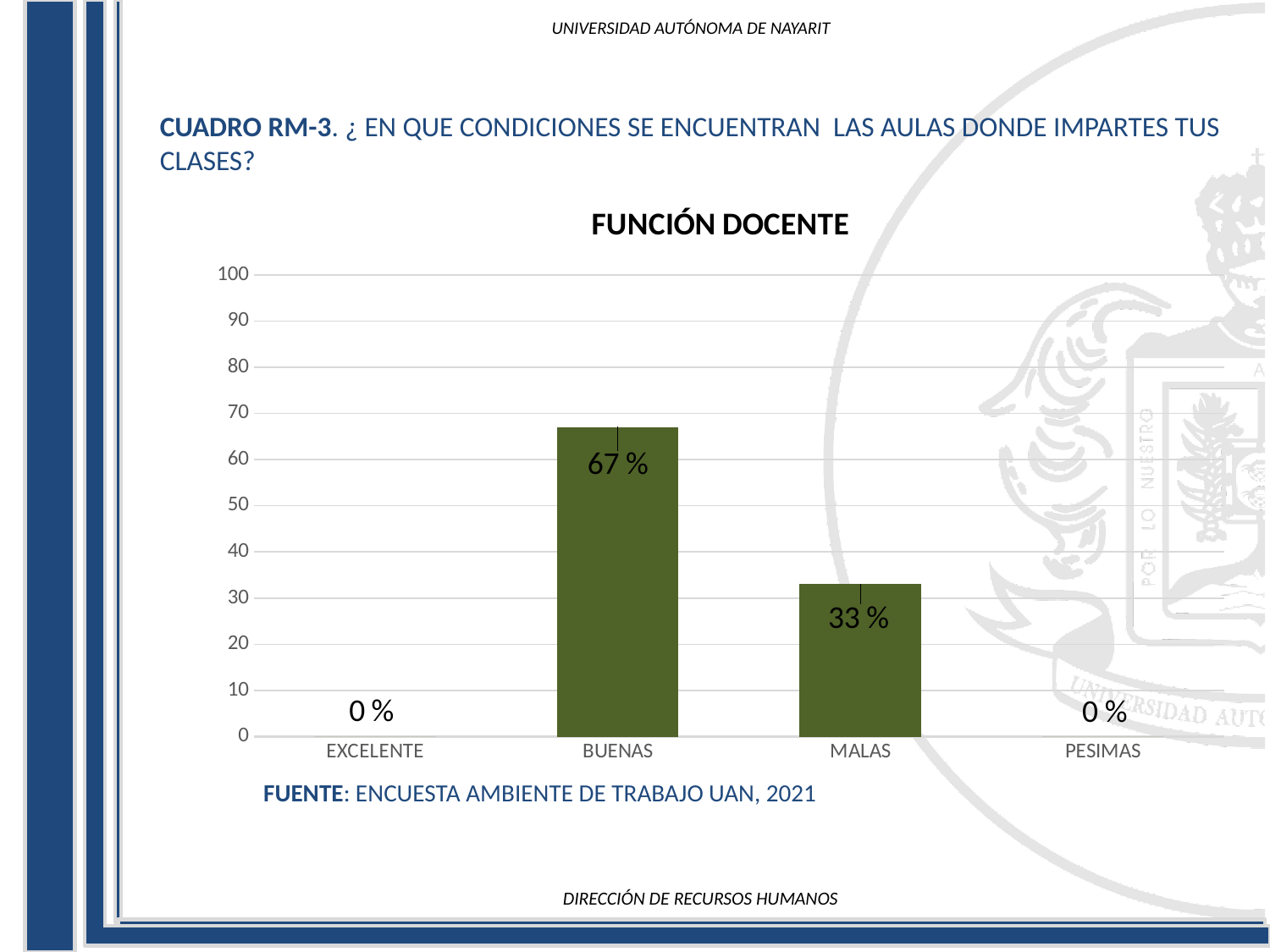
What is the value for PESIMAS? 0 % What is the title of the chart? FUNCIÓN DOCENTE What kind of chart is shown on the slide? bar chart Which category has the highest value? BUENAS What is the value for MALAS? 33 % What is the value for EXCELENTE? 0 % Is the value for BUENAS greater or less than 60? greater Is the value for MALAS greater or less than 40? less What is the value for BUENAS? 67 % What is the difference between the values for BUENAS and MALAS? 34 % Which is larger, the value for BUENAS or the value for MALAS? BUENAS How many categories are shown on the x axis? 4